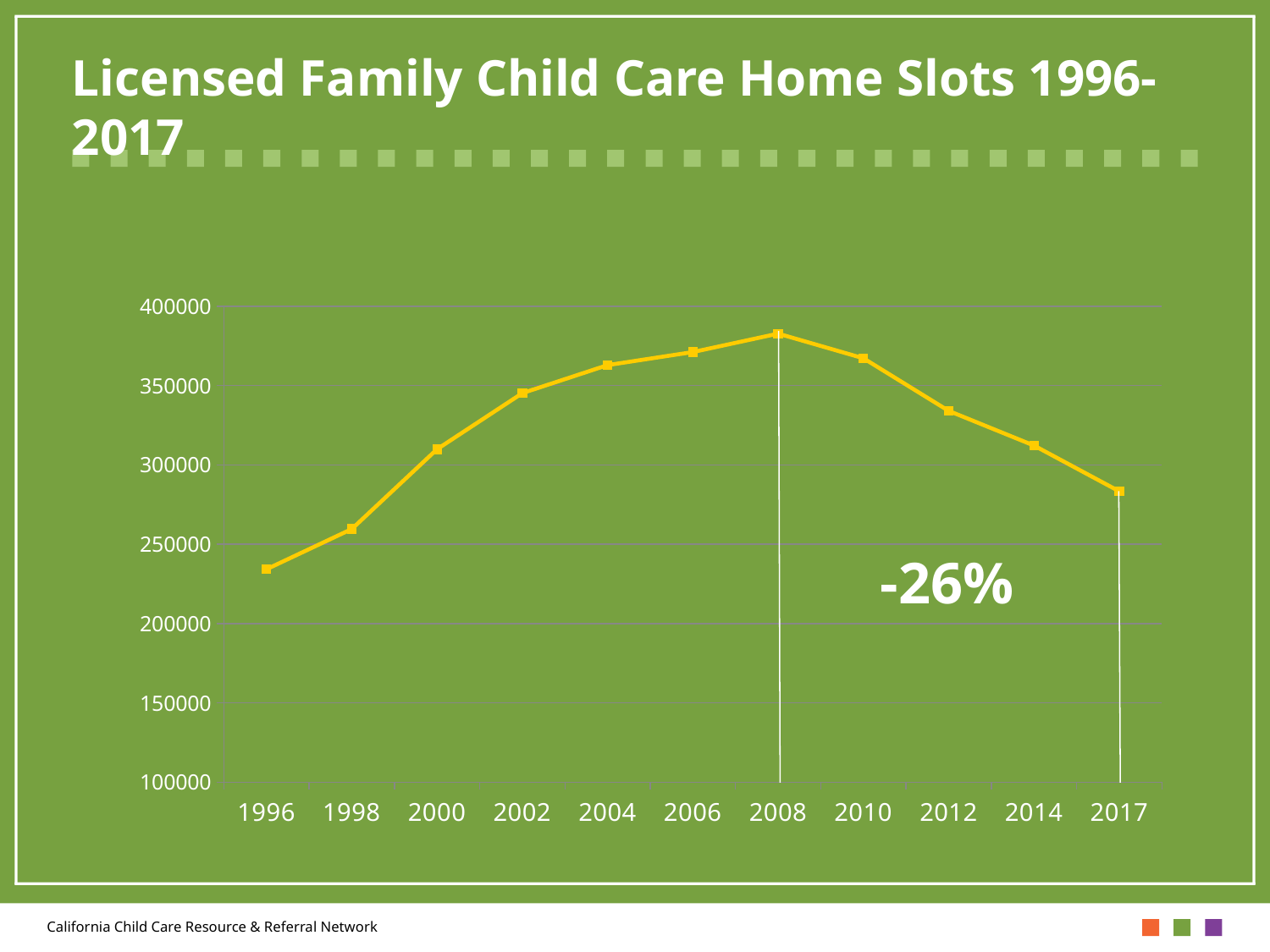
In which year is the number of licensed family child care home slots highest? 2008 Is the value for 2012 greater or less than 350000? less Which year has the larger value, 1996 or 2017? 2017 What kind of chart is shown on the slide? line chart Is the value for 2008 greater or less than 350000? greater What percentage change is annotated on the chart between 2008 and 2017? -26% Do the values rise or fall from 2008 to 2017? fall Is the value for 2017 greater or less than 300000? less In which year is the number of licensed family child care home slots lowest? 1996 How many years are plotted on the x axis of the chart? 11 Which year has the larger value, 2008 or 2017? 2008